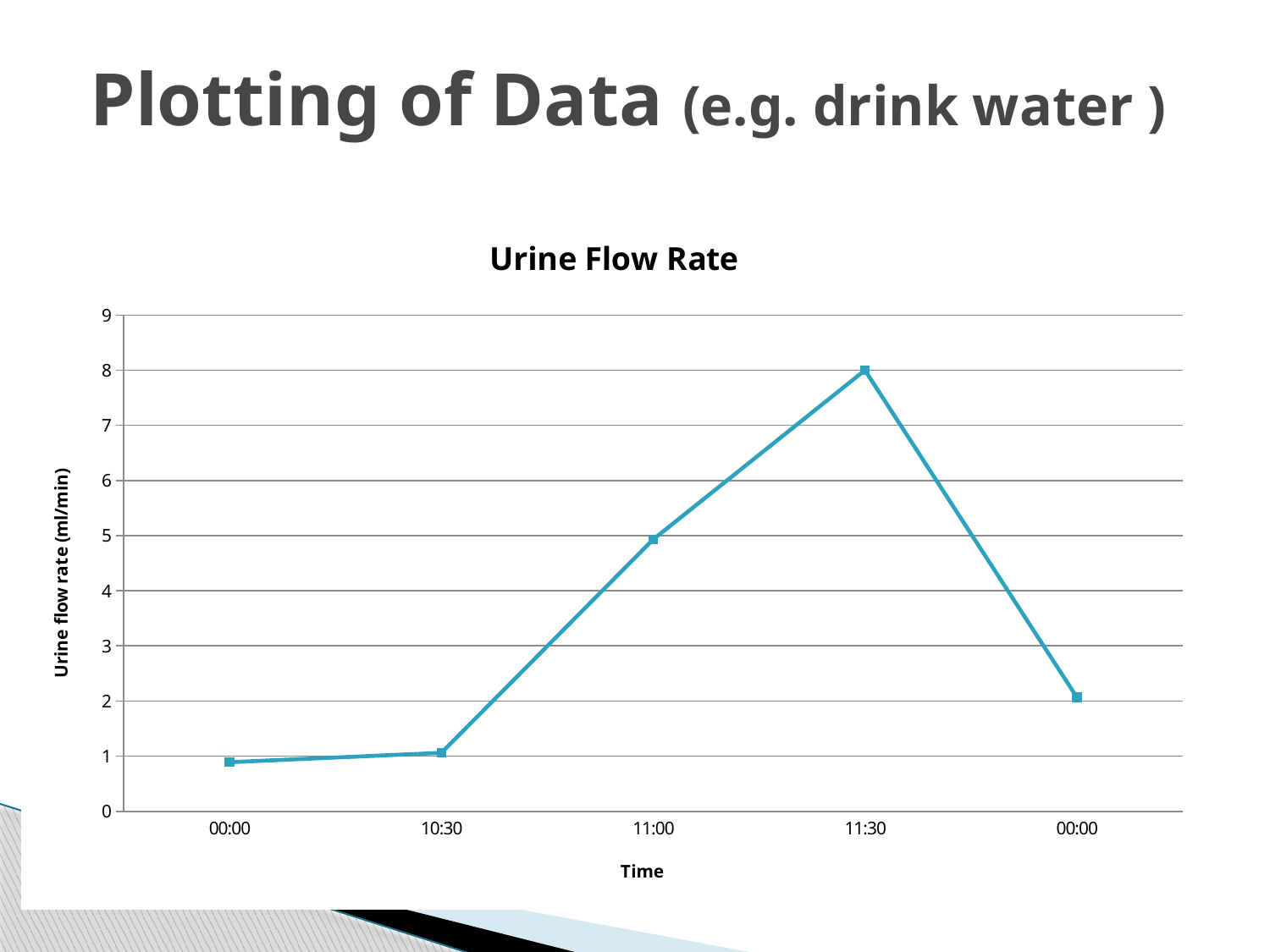
Is the urine flow rate at 10:30 greater or less than 2? less Which has a higher urine flow rate, 10:30 or 11:00? 11:00 What is the title of the chart? Urine Flow Rate Is the urine flow rate at the final 00:00 point greater or less than 3? less What kind of chart is shown on the slide? line chart Which has a higher urine flow rate, 11:30 or the final 00:00 point? 11:30 At which time is the urine flow rate highest? 11:30 What is the urine flow rate at 11:30? 8 Is the urine flow rate at 11:00 greater or less than 4? greater How many data points are plotted on the line? 5 Does the urine flow rate rise or fall between 10:30 and 11:30? rise What is the label on the vertical axis of the chart? Urine flow rate (ml/min)